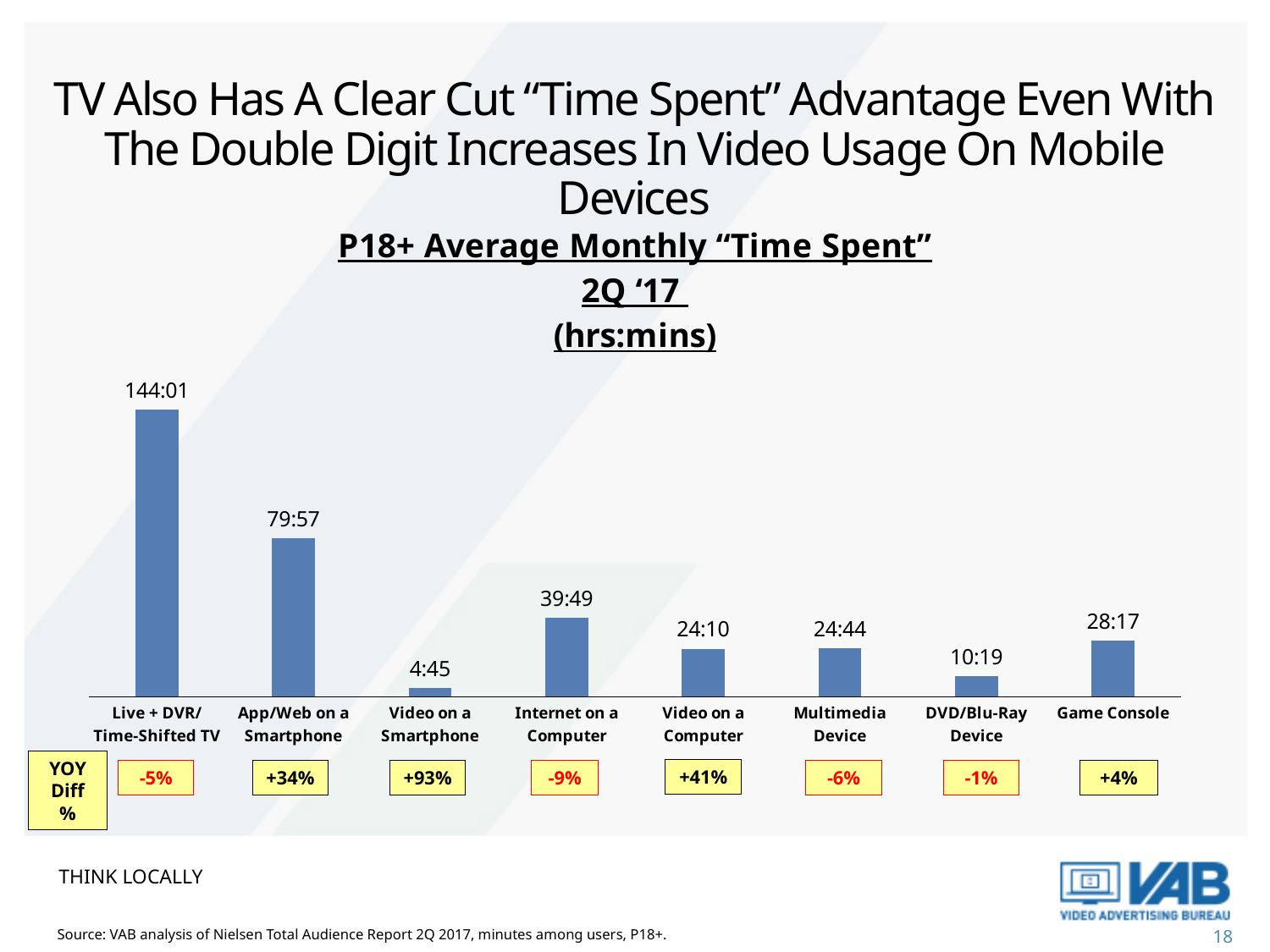
What kind of chart is shown on the slide? bar chart What is the average monthly time spent for App/Web on a Smartphone? 79:57 Which category has the highest average monthly time spent? Live + DVR/Time-Shifted TV Which is larger, the value for Video on a Computer or the value for Multimedia Device? Multimedia Device How many categories are plotted in the chart? 8 What is the value shown for Video on a Smartphone? 4:45 What unit is the chart's time spent measured in, according to the chart title? hrs:mins Which category has the lowest average monthly time spent? Video on a Smartphone What is the average monthly time spent for Live + DVR/Time-Shifted TV? 144:01 What is the difference between the values for Internet on a Computer and Video on a Computer? 15:39 What is the YOY Diff % shown for Video on a Smartphone? +93% What is the value shown for Game Console? 28:17